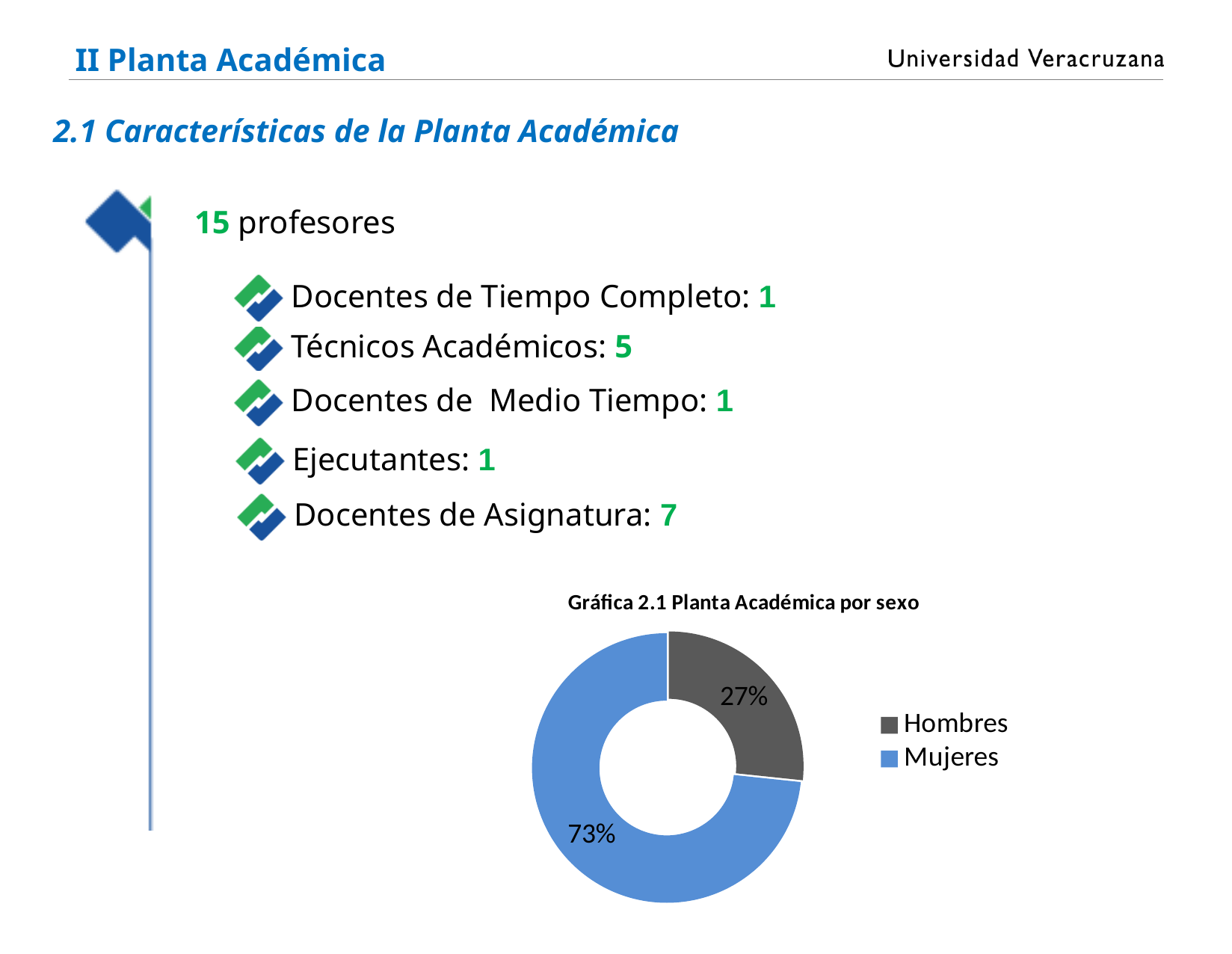
Which is larger in the chart, Hombres or Mujeres? Mujeres What is the title of the chart on the slide? Gráfica 2.1 Planta Académica por sexo What is the difference in percentage points between Mujeres and Hombres in the chart? 46 What kind of chart is shown on the slide? doughnut chart Which category has the smallest share in the chart? Hombres Which colour represents Mujeres in the chart? blue What is the combined share of Hombres and Mujeres in the chart? 100% Which category has the largest share in the chart? Mujeres How many categories does the chart show? 2 What percentage of the chart does Hombres represent? 27% How many entries does the chart legend list? 2 What percentage of the chart does Mujeres represent? 73%